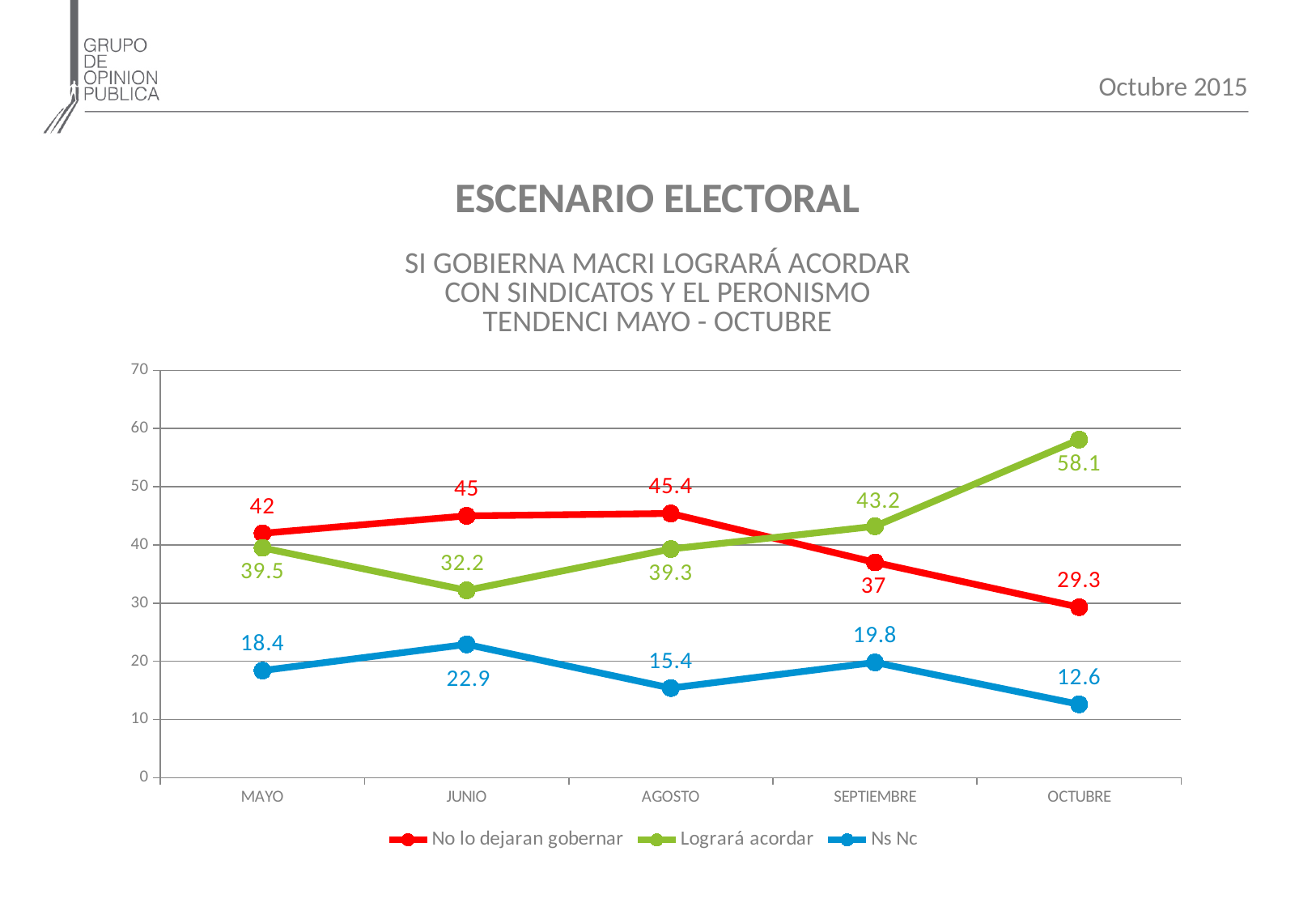
How many series does the legend list? 3 What is the value for "Ns Nc" in JUNIO? 22.9 How many months are shown on the x axis? 5 Does "No lo dejaran gobernar" rise or fall from AGOSTO to OCTUBRE? Fall What is the difference between "Logrará acordar" and "No lo dejaran gobernar" in OCTUBRE? 28.8 What is the value for "No lo dejaran gobernar" in AGOSTO? 45.4 What is the value for "Logrará acordar" in OCTUBRE? 58.1 What colour is the line for "Ns Nc"? Blue In which month does "Logrará acordar" reach its highest value? OCTUBRE In which month is "Ns Nc" lowest? OCTUBRE In SEPTIEMBRE, which is larger: "No lo dejaran gobernar" or "Logrará acordar"? Logrará acordar What kind of chart is shown on the slide? Line chart